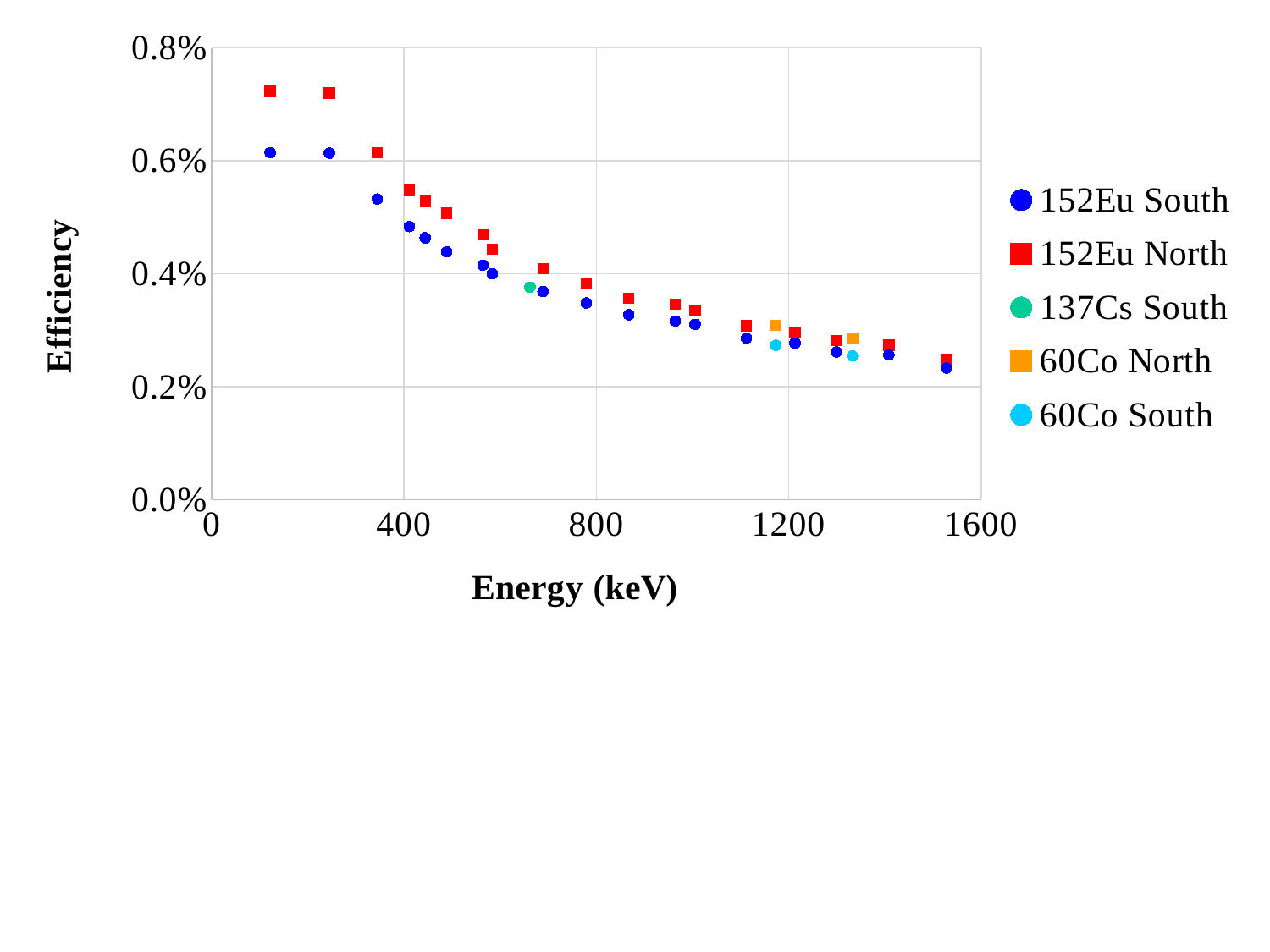
How many series does the legend list? 5 What is the label of the x axis? Energy (keV) What is the label of the y axis? Efficiency Do the efficiency values rise or fall as energy increases along the x axis? fall What kind of chart is shown on the slide? scatter chart Is the efficiency of the lowest-energy 152Eu South point greater or less than 0.4%? greater Which series contains the point with the highest efficiency on the chart? 152Eu North At the lowest energy plotted, which series has the larger efficiency, 152Eu North or 152Eu South? 152Eu North Is the efficiency of the 137Cs South point greater or less than 0.4%? less How many points are plotted for the 137Cs South series? 1 Is the efficiency of the lowest-energy 152Eu North point greater or less than 0.6%? greater